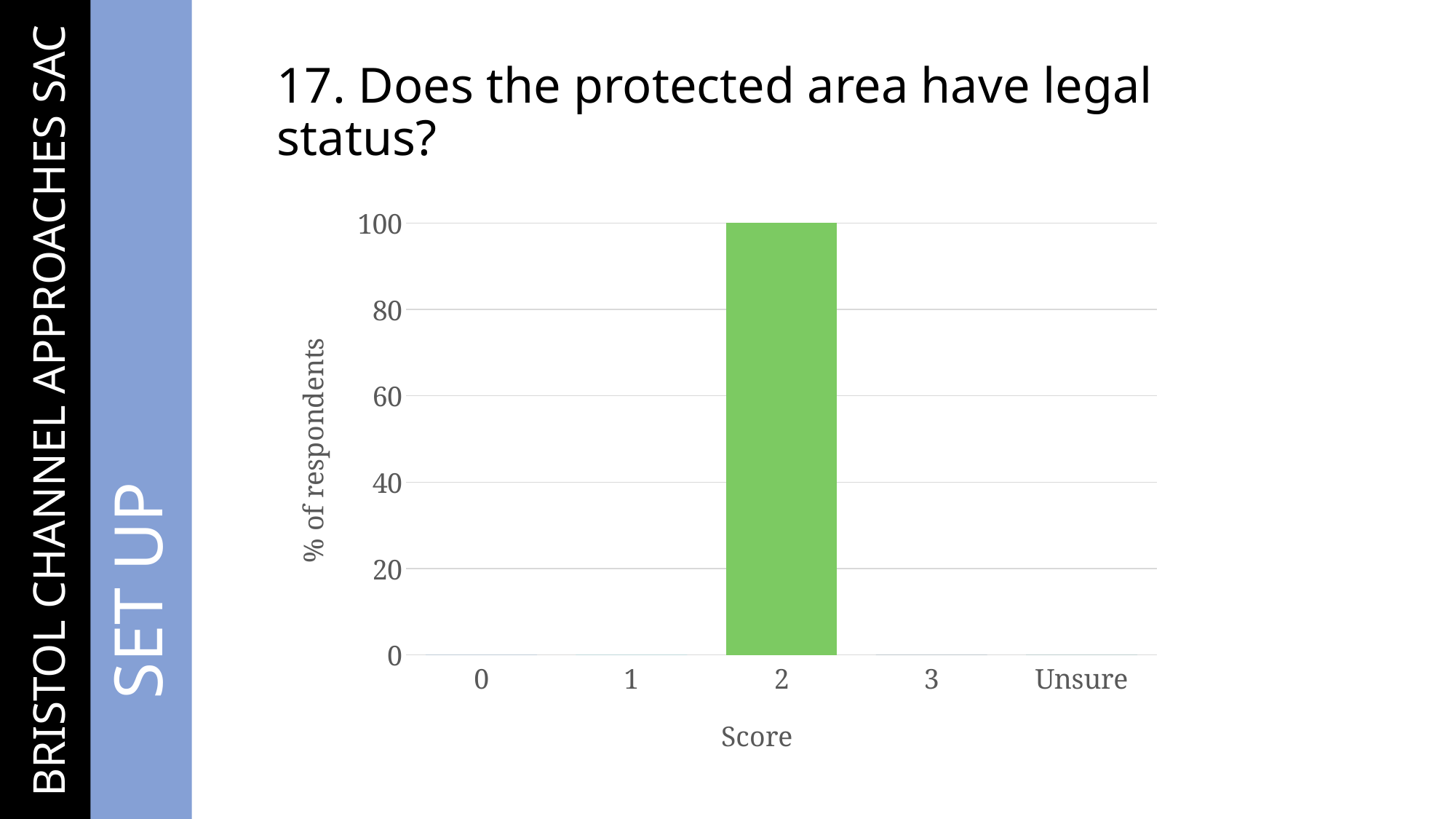
What type of chart is shown on the slide? Bar chart What is the label of the y axis? % of respondents What is the difference between the value for score 2 and the value for score 1? 100 What is the percentage of respondents for the Unsure category? 0 Is the value for score 2 greater or less than 80? greater Which score category has the highest percentage of respondents? 2 What is the percentage of respondents for score 2? 100 What is the percentage of respondents for score 0? 0 Which is larger, the value for score 2 or the value for score 3? Score 2 What is the label of the x axis? Score How many score categories are shown on the x axis? 5